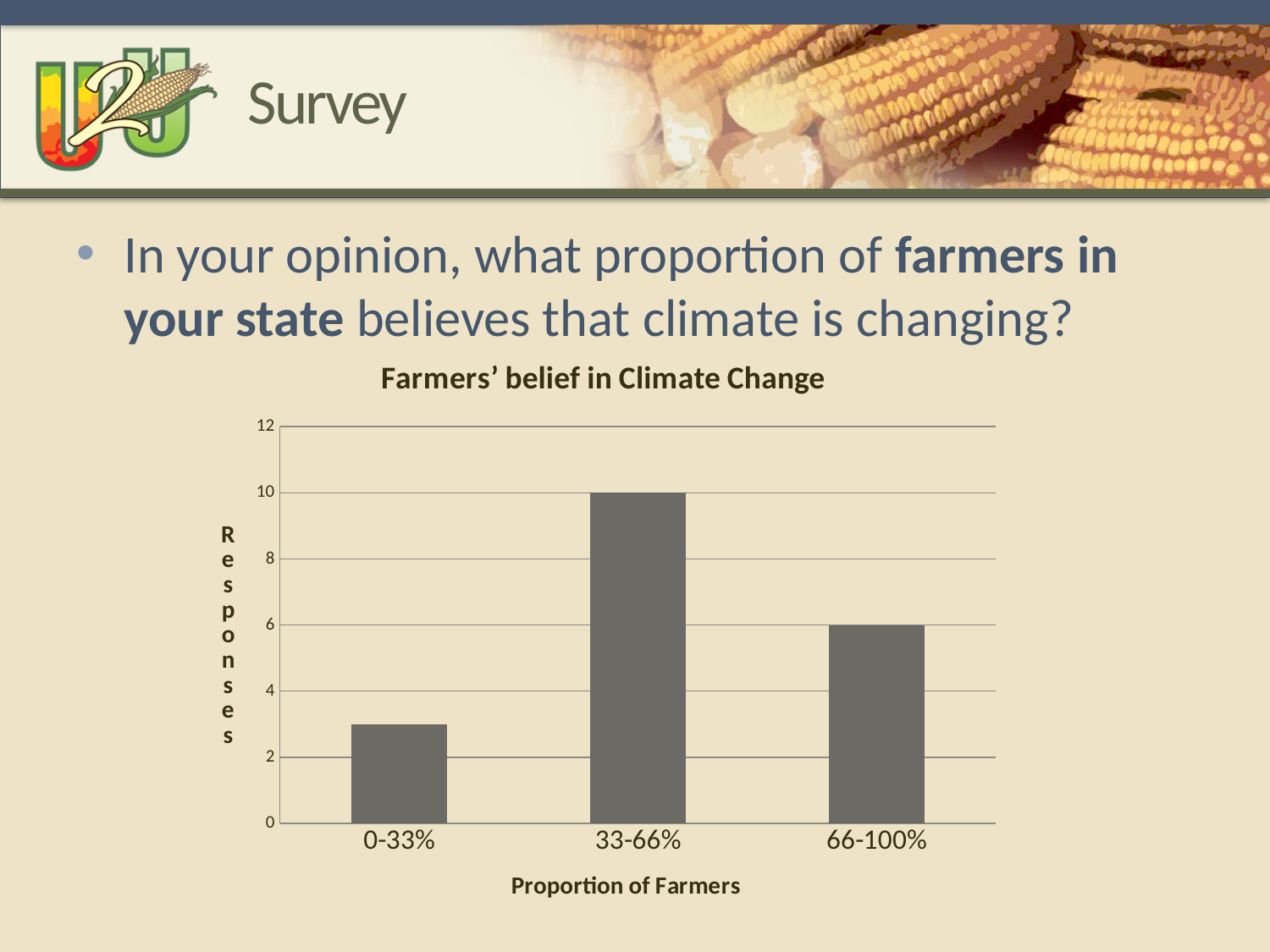
What type of chart is shown on the slide? bar chart Which category has the highest number of responses? 33-66% Which category has more responses, 0-33% or 66-100%? 66-100% Which category has the lowest number of responses? 0-33% How many responses are shown for the 33-66% category? 10 What is the title of the chart? Farmers' belief in Climate Change Is the value for 0-33% greater or less than 2? greater What is the label of the x axis of the chart? Proportion of Farmers Is the value for 0-33% greater or less than 4? less How many responses are shown for the 66-100% category? 6 What is the difference in responses between the 33-66% and 66-100% categories? 4 How many categories are shown on the x axis of the chart? 3